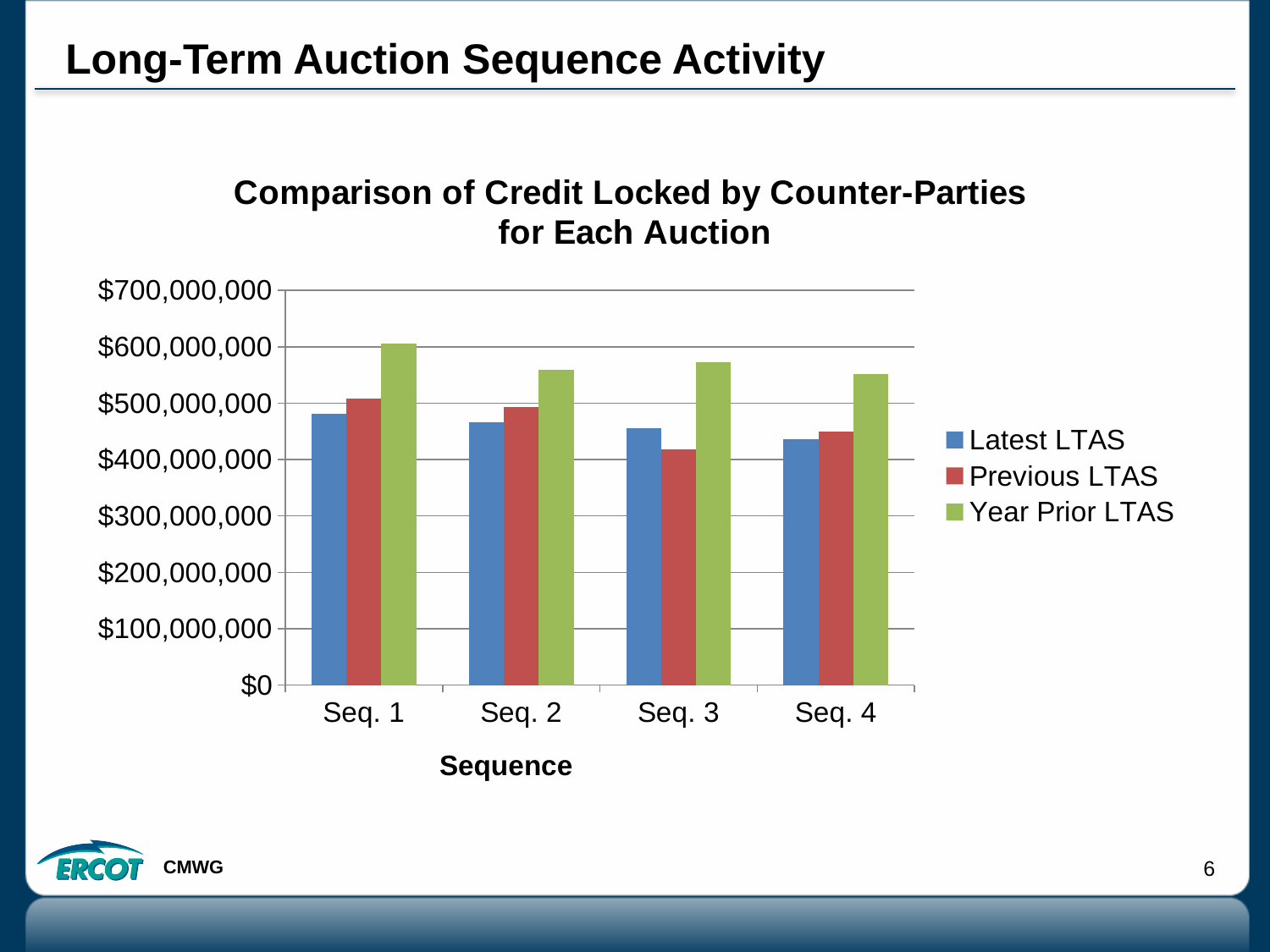
How many series does the legend list? 3 Which series has the lowest value for Seq. 3? Previous LTAS Do the Latest LTAS values rise or fall from Seq. 1 to Seq. 4? fall Is the Year Prior LTAS value for Seq. 2 greater or less than $500,000,000? greater For Seq. 1, which is larger: Latest LTAS or Previous LTAS? Previous LTAS For Seq. 3, which is larger: Latest LTAS or Previous LTAS? Latest LTAS What kind of chart is shown on the slide? Bar chart For which sequence is the Year Prior LTAS value highest? Seq. 1 Which series has the highest value for Seq. 3? Year Prior LTAS For which sequence is the Previous LTAS value lowest? Seq. 3 Is the Previous LTAS value for Seq. 3 greater or less than $500,000,000? less How many sequence categories are shown on the x axis? 4